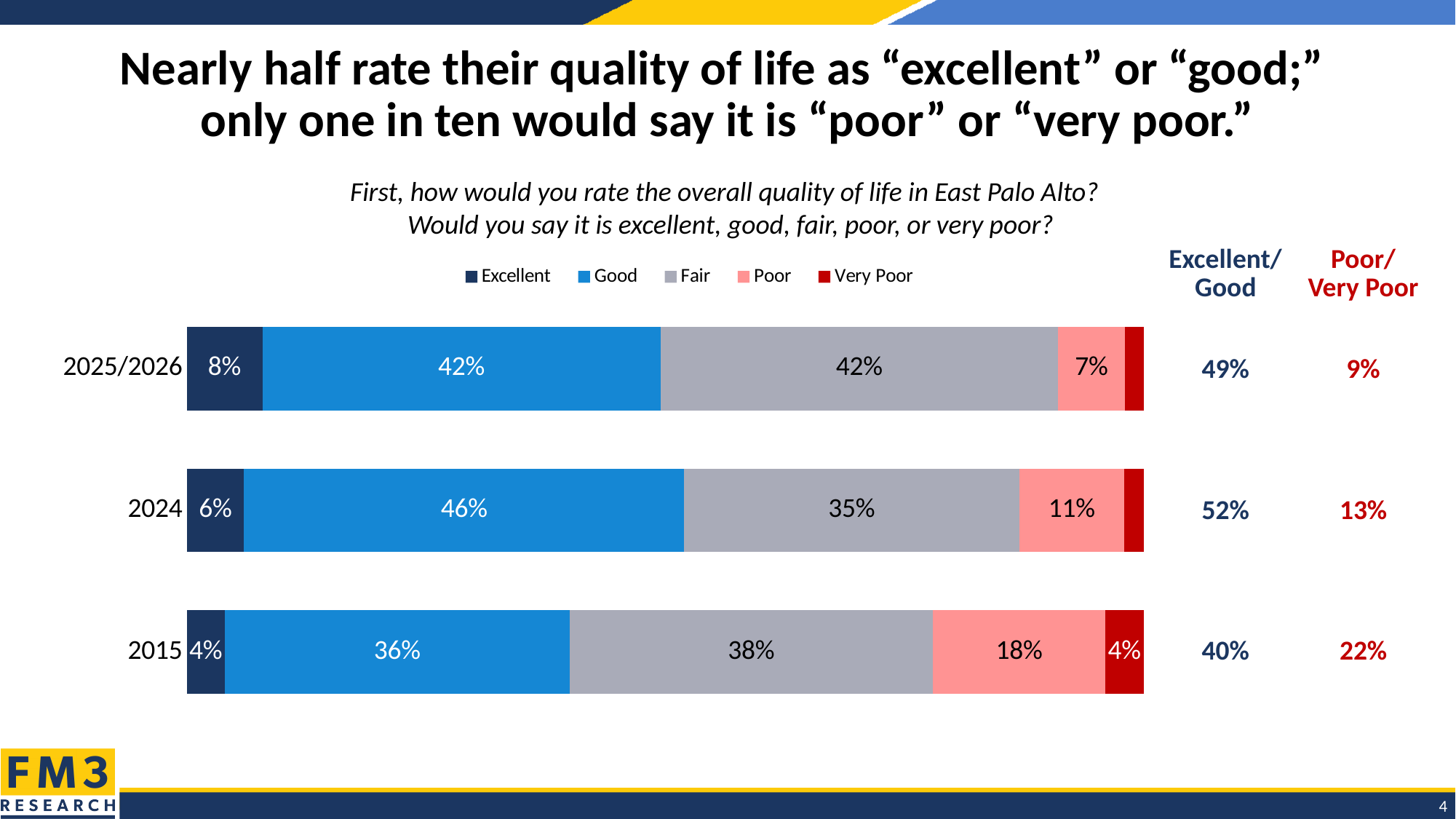
What is the combined "Poor/Very Poor" percentage shown for 2015? 22% What kind of chart is shown on the slide? Stacked bar chart What percentage rated quality of life as "Good" in 2024? 46% How many years (categories) are shown in the chart? 3 What percentage rated quality of life as "Poor" in 2015? 18% Is the "Fair" percentage larger in 2025/2026 or in 2024? 2025/2026 What is the difference between the "Good" percentage in 2024 and in 2015? 10% How many series does the legend list? 5 Which year has the lowest "Poor" percentage? 2025/2026 Which year has the highest "Excellent" percentage? 2025/2026 What percentage rated quality of life as "Fair" in 2025/2026? 42% What is the combined "Excellent/Good" percentage shown for 2024? 52%